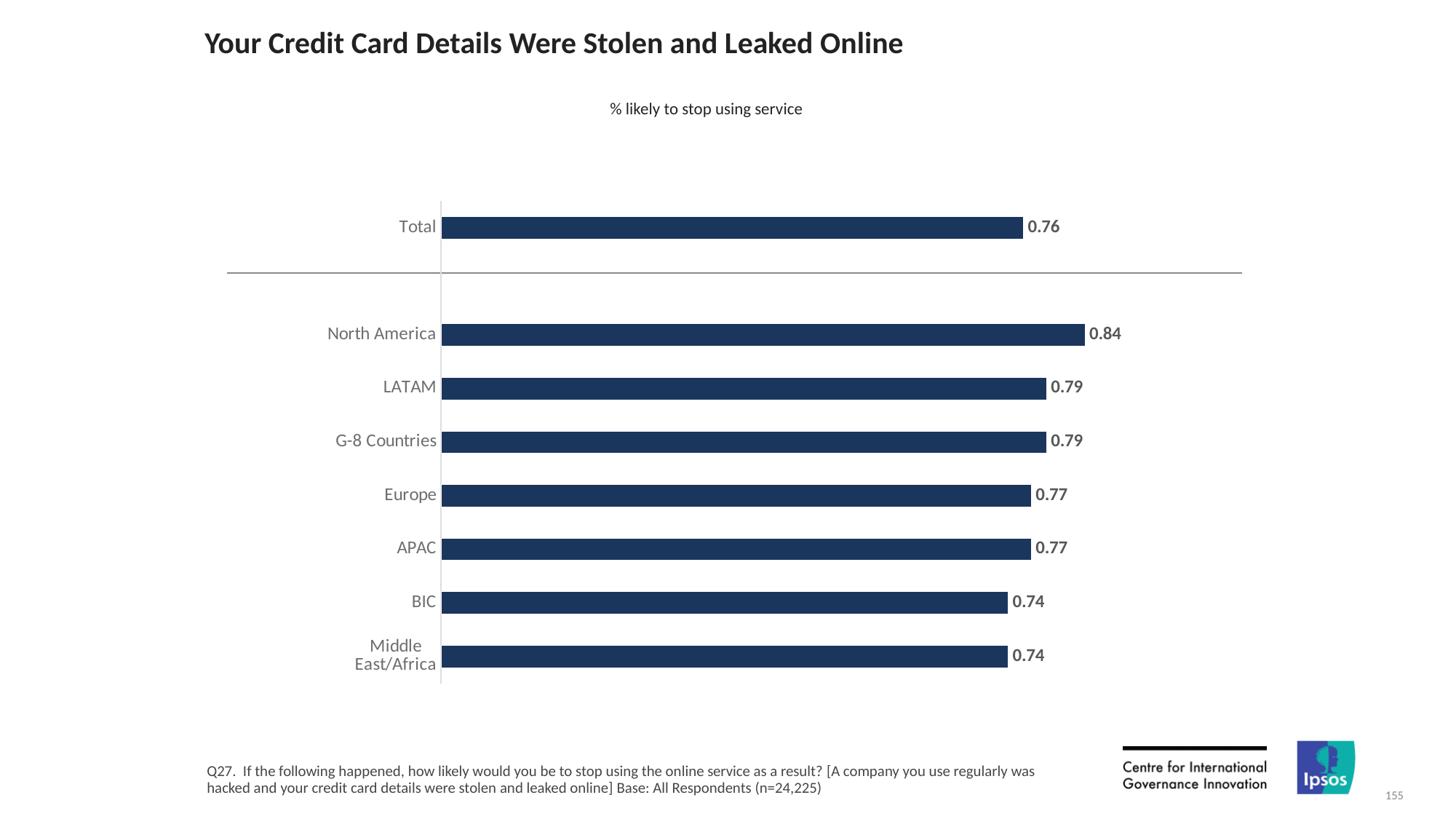
Which region has the highest value? North America What is the subtitle shown above the chart? % likely to stop using service What is the value for Middle East/Africa? 0.74 How many bars are shown in the chart, including Total? 8 What is the value for Europe? 0.77 Which is larger, the value for G-8 Countries or the value for Middle East/Africa? G-8 Countries What kind of chart is shown on the slide? Bar chart What is the difference between the values for LATAM and Total? 0.03 What is the difference between the values for North America and BIC? 0.10 Which is larger, the value for North America or the value for APAC? North America What is the value for Total? 0.76 What is the value for North America? 0.84